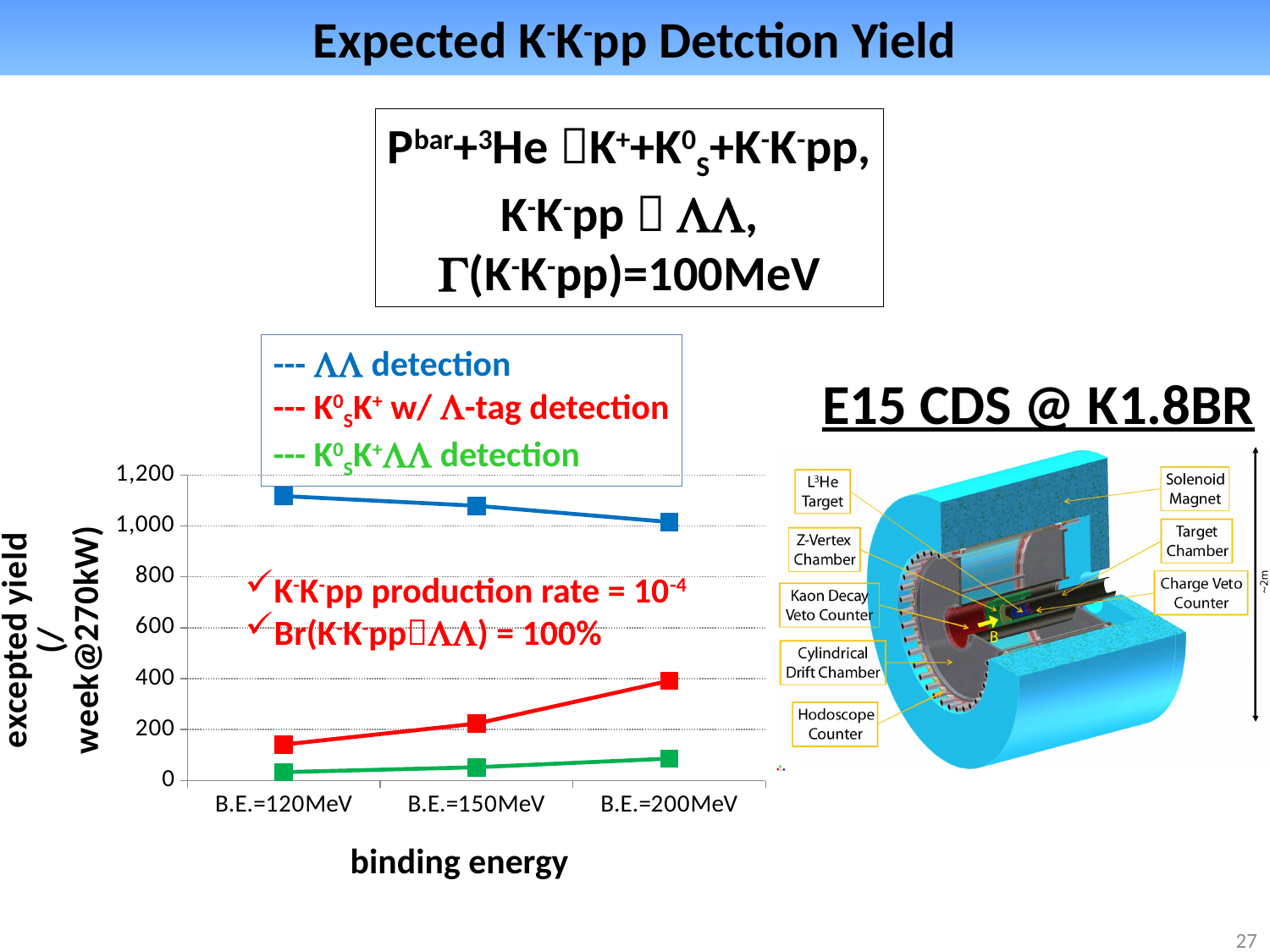
Is the K0sK+ w/ Λ-tag detection yield at B.E.=200MeV greater or less than 200? greater What is the label of the x axis of the chart? binding energy Does the ΛΛ detection yield rise or fall as binding energy increases from 120MeV to 200MeV? fall Is the K0sK+ΛΛ detection yield at B.E.=200MeV greater or less than 200? less Is the ΛΛ detection yield at B.E.=120MeV greater or less than 1,000? greater Does the K0sK+ w/ Λ-tag detection yield rise or fall as binding energy increases from 120MeV to 200MeV? rise How many binding energy categories are plotted on the x axis? 3 How many series does the chart legend list? 3 At B.E.=120MeV, which series has the larger yield: ΛΛ detection or K0sK+ w/ Λ-tag detection? ΛΛ detection What kind of chart is shown on the slide? line chart